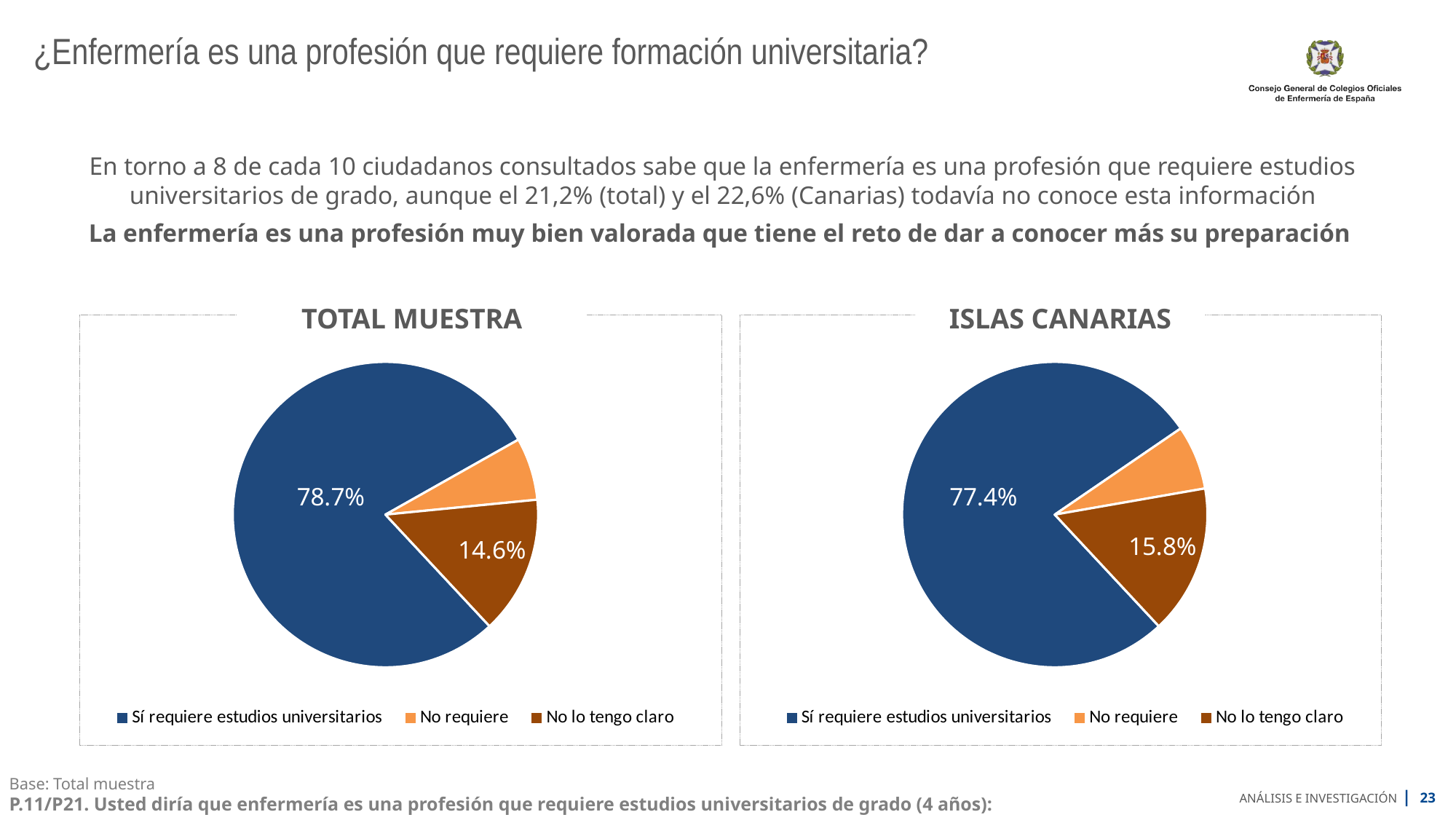
Which chart shows a larger value for 'No lo tengo claro', TOTAL MUESTRA or ISLAS CANARIAS? ISLAS CANARIAS In the ISLAS CANARIAS chart, what percentage is shown for 'Sí requiere estudios universitarios'? 77.4% What is the difference in percentage points between 'Sí requiere estudios universitarios' in the TOTAL MUESTRA chart and in the ISLAS CANARIAS chart? 1.3 percentage points In the ISLAS CANARIAS chart, which category has the smallest slice? No requiere How many slices does the TOTAL MUESTRA pie chart have? 3 In the TOTAL MUESTRA chart, which category has the largest slice? Sí requiere estudios universitarios In the TOTAL MUESTRA chart, what colour is the 'No requiere' slice? Orange In the ISLAS CANARIAS chart, what percentage is shown for 'No lo tengo claro'? 15.8% How many entries does the legend of the ISLAS CANARIAS chart list? 3 What type of chart is used for ISLAS CANARIAS? Pie chart In the TOTAL MUESTRA chart, what percentage is shown for 'Sí requiere estudios universitarios'? 78.7% In the TOTAL MUESTRA chart, what percentage is shown for 'No lo tengo claro'? 14.6%